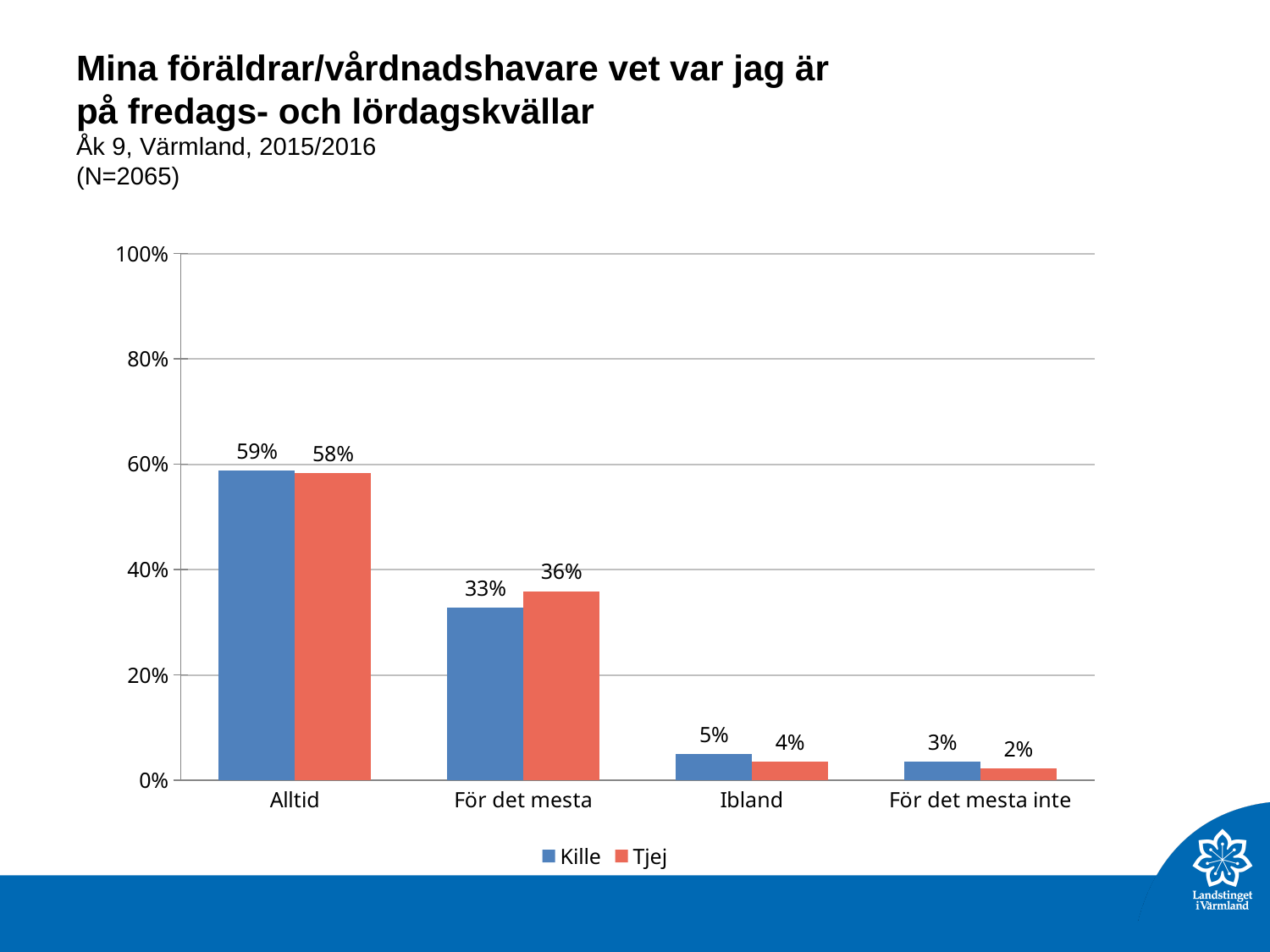
What is the value for Kille in the Alltid category? 59% In the Ibland category, which series has the larger value, Kille or Tjej? Kille How many categories are shown on the x axis? 4 How many series does the legend list? 2 Is the value for Kille in the För det mesta category greater or less than 40%? less What are the two series named in the legend? Kille and Tjej What is the difference between the Tjej and Kille values in the För det mesta category? 3% What is the value for Tjej in the För det mesta category? 36% What kind of chart is shown on the slide? bar chart Which category has the highest value for Tjej? Alltid What is the value for Tjej in the För det mesta inte category? 2% Which category has the lowest value for Kille? För det mesta inte